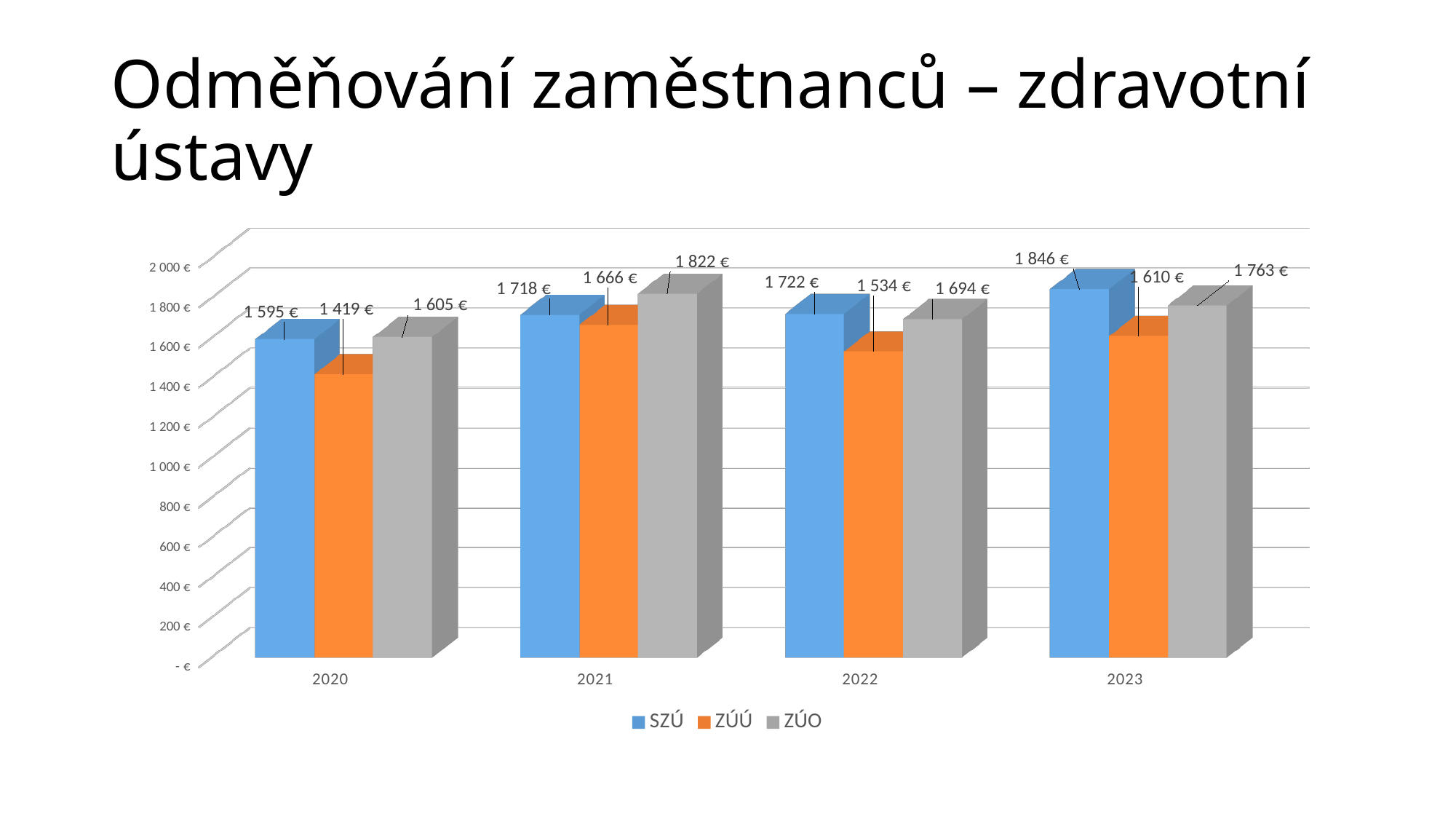
How many years are shown on the x axis? 4 In which year is the ZÚO value highest? 2021 What is the value for SZÚ in 2020? 1 595 € What kind of chart is shown on the slide? bar chart In which year is the ZÚÚ value lowest? 2020 What is the difference between the SZÚ and ZÚÚ values in 2023? 236 € Is the value for ZÚÚ in 2020 greater or less than 1 600 €? less What is the value for ZÚÚ in 2022? 1 534 € How many series does the legend list? 3 Which is larger in 2022, the SZÚ value or the ZÚO value? SZÚ What is the value for SZÚ in 2023? 1 846 € What is the value for ZÚO in 2021? 1 822 €